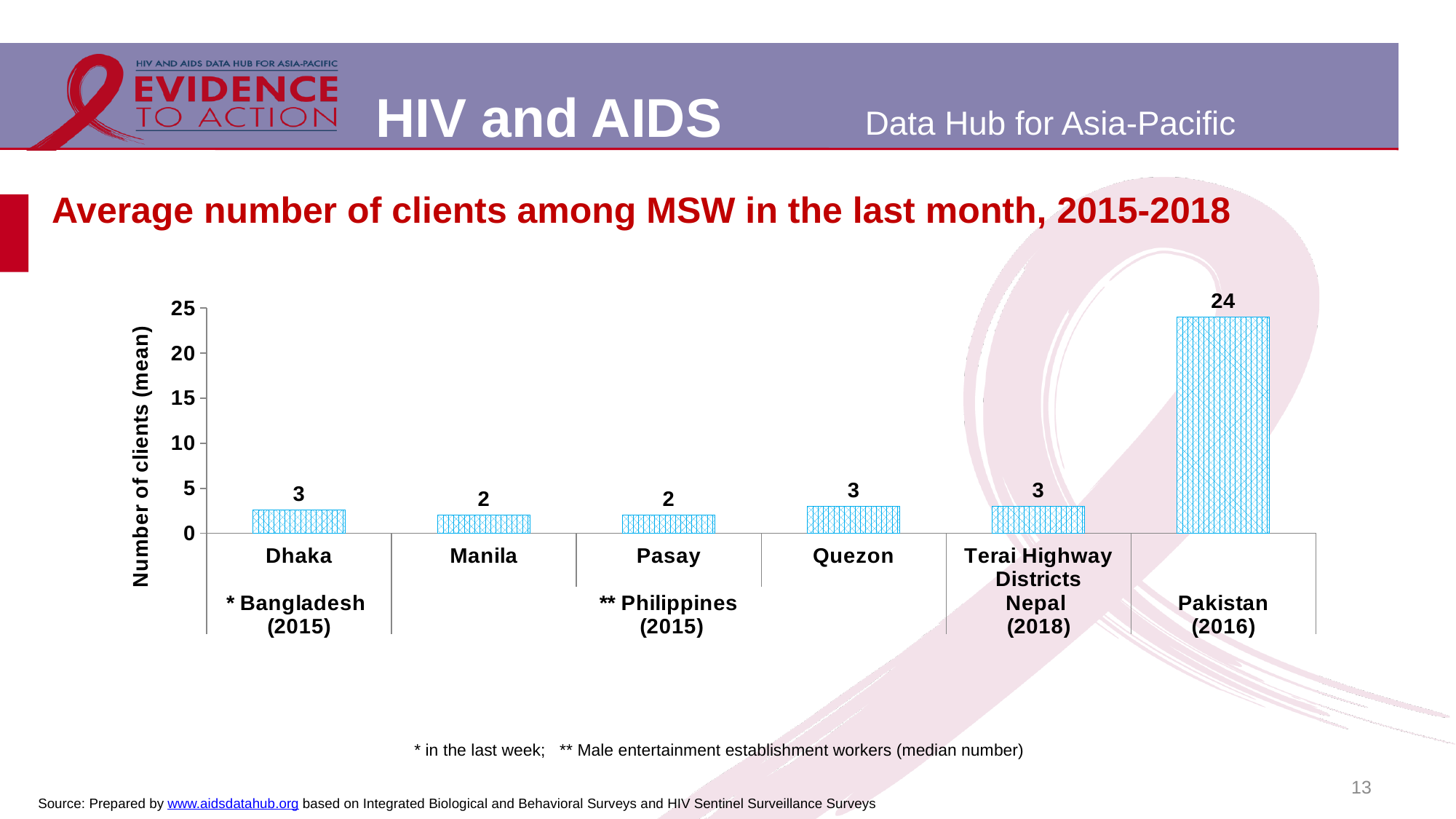
What is the difference between the values for Pakistan and Quezon? 21 What is the label of the vertical axis? Number of clients (mean) What is the title of the chart? Average number of clients among MSW in the last month, 2015-2018 Which category has the highest average number of clients? Pakistan (2016) How many bars are plotted in the chart? 6 What is the average number of clients for Dhaka? 3 What type of chart is shown on the slide? bar chart What is the value shown for Terai Highway Districts, Nepal (2018)? 3 What is the average number of clients for Pakistan (2016)? 24 Which is larger, the value for Dhaka or the value for Pasay? Dhaka Is the value for Pakistan greater or less than 20? greater What is the value shown for Manila? 2